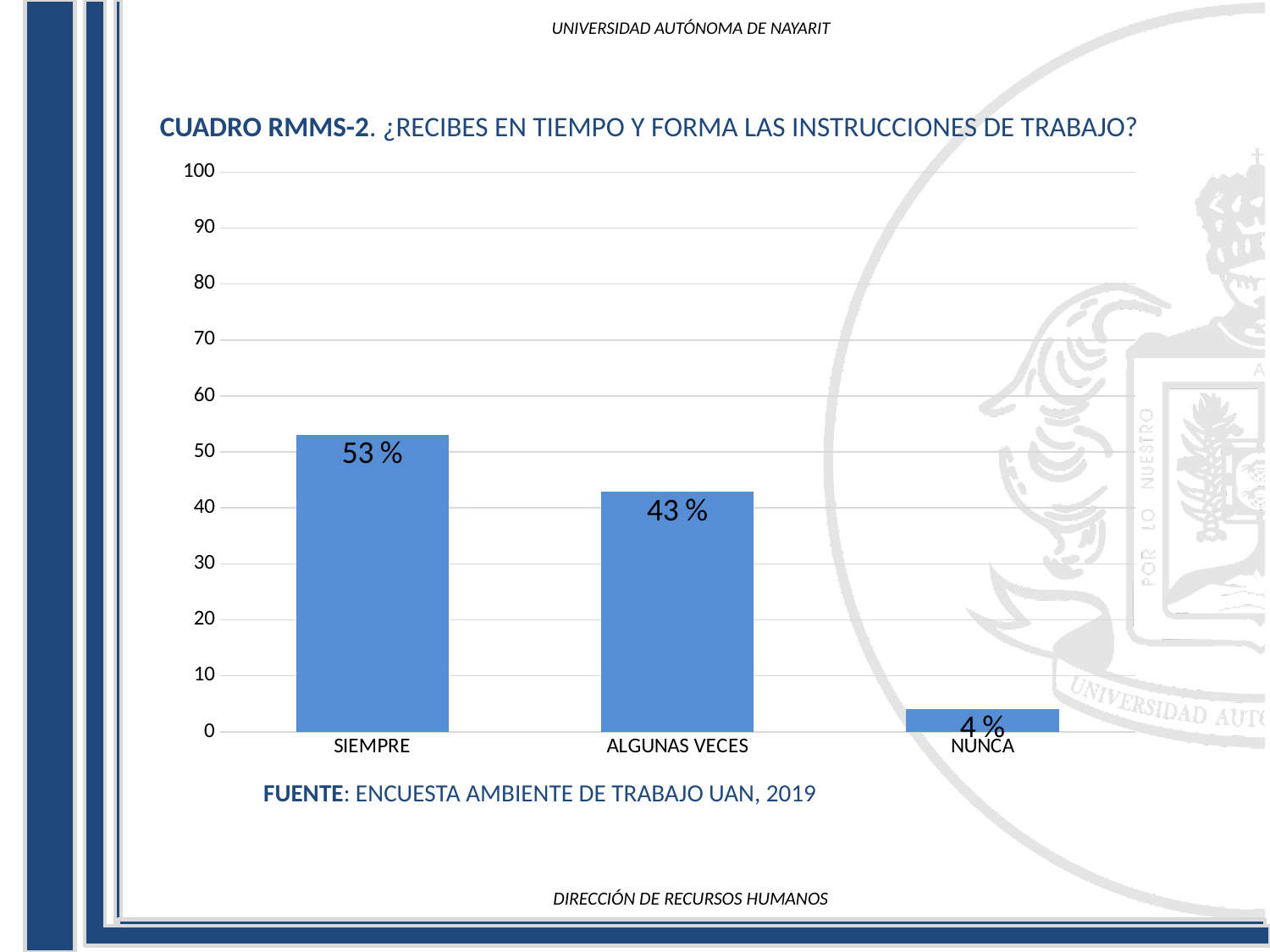
Is the value for SIEMPRE greater or less than 50? greater What kind of chart is shown on the slide? bar chart How many categories are shown on the x axis? 3 Which category has the highest value? SIEMPRE What is the difference between the values for ALGUNAS VECES and NUNCA? 39 % What source is cited below the chart? ENCUESTA AMBIENTE DE TRABAJO UAN, 2019 What is the value for SIEMPRE? 53 % What is the difference between the values for SIEMPRE and ALGUNAS VECES? 10 % Which category has the lowest value? NUNCA What is the value for ALGUNAS VECES? 43 % What is the value for NUNCA? 4 % Which is larger, the value for ALGUNAS VECES or the value for NUNCA? ALGUNAS VECES